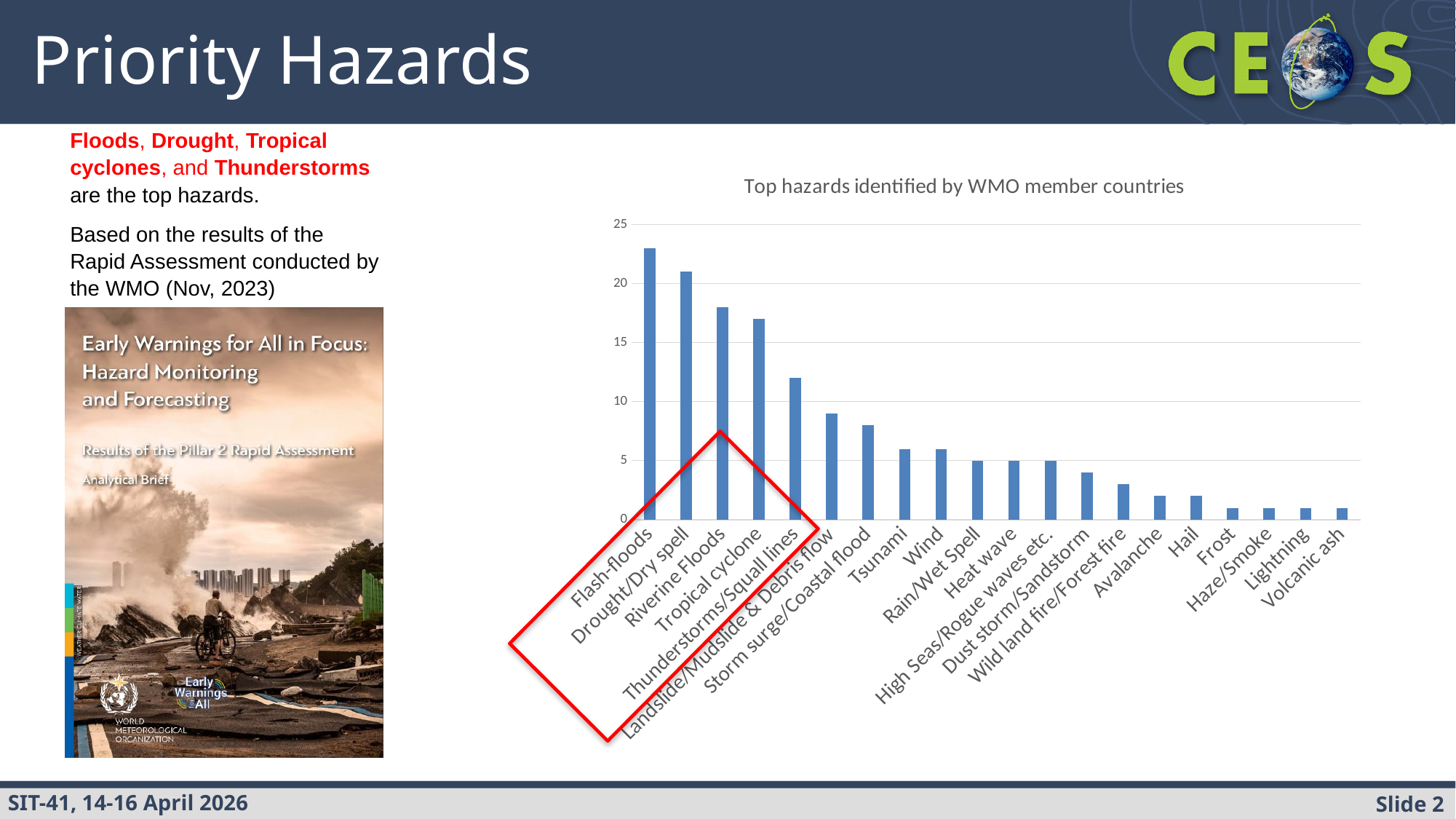
Which has a larger value, Drought/Dry spell or Storm surge/Coastal flood? Drought/Dry spell Which hazard has the highest value on the chart? Flash-floods Which has a larger value, Riverine Floods or Tsunami? Riverine Floods What kind of chart is shown on the slide? bar chart Is the value for Tropical cyclone greater or less than 15? greater Is the value for Thunderstorms/Squall lines greater or less than 10? greater Is the value for Avalanche greater or less than 5? less What is the title of the chart? Top hazards identified by WMO member countries How many hazard categories are plotted on the chart? 20 Do the values rise or fall moving from left to right along the x axis? fall